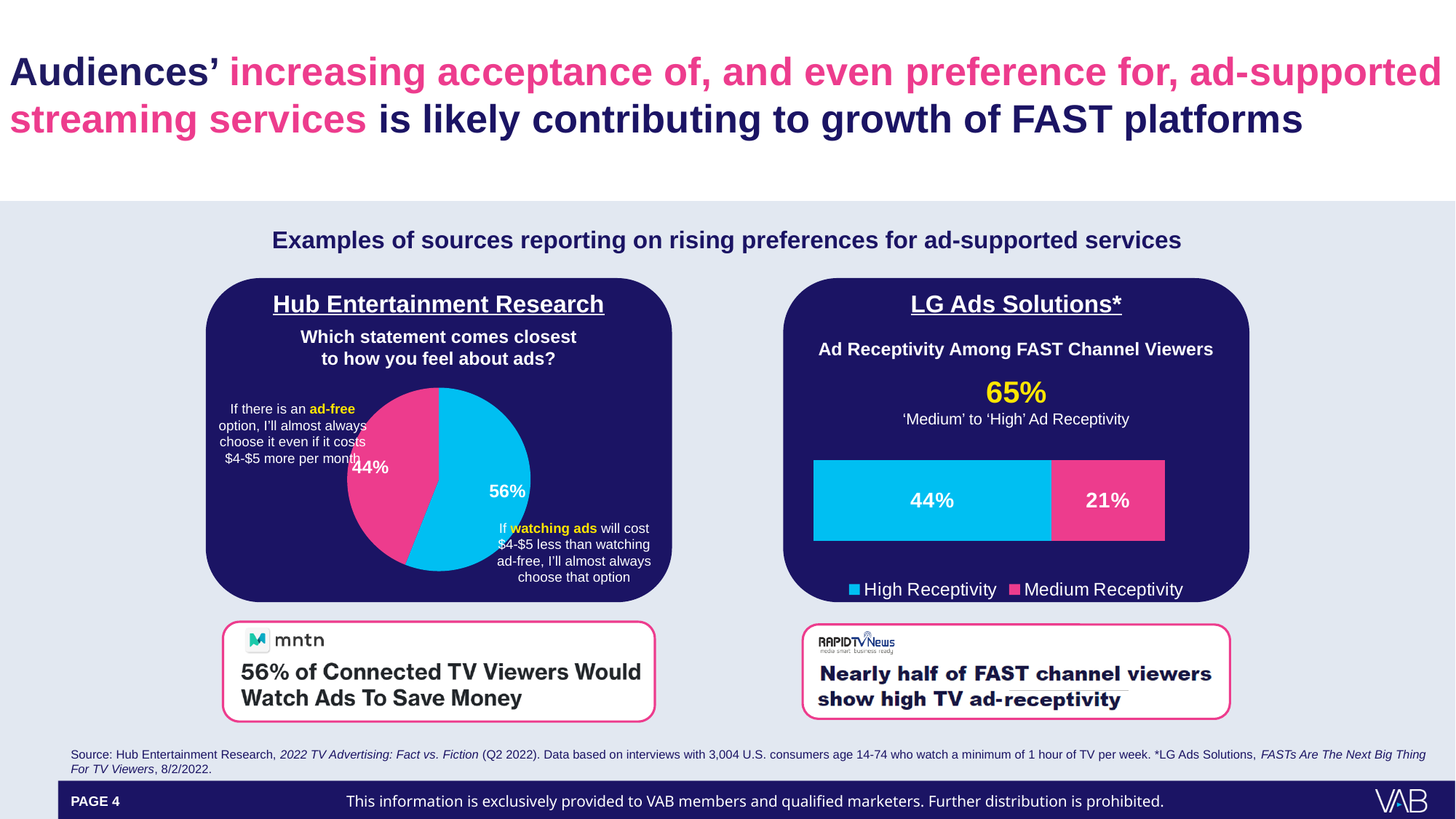
In the LG Ads Solutions chart, which series has the larger value, High Receptivity or Medium Receptivity? High Receptivity How many slices does the Hub Entertainment Research pie chart have? 2 In the Hub Entertainment Research pie chart, what share of respondents said they would almost always choose the ad-free option even if it costs $4-$5 more per month? 44% In the LG Ads Solutions chart, how many series does the legend list? 2 In the Hub Entertainment Research pie chart, which statement has the larger share: the ad-free option or the watching ads option? Watching ads What type of chart is shown in the Hub Entertainment Research panel? Pie chart In the LG Ads Solutions chart, what colour represents Medium Receptivity? Pink In the LG Ads Solutions chart, what is the value for Medium Receptivity? 21% In the Hub Entertainment Research pie chart, what is the difference in percentage points between the watching ads slice and the ad-free slice? 12 percentage points In the Hub Entertainment Research pie chart, what share of respondents said they would choose the option where watching ads costs $4-$5 less? 56% In the LG Ads Solutions chart, what is the value for High Receptivity? 44% In the LG Ads Solutions chart, what is the combined total of High Receptivity and Medium Receptivity? 65%